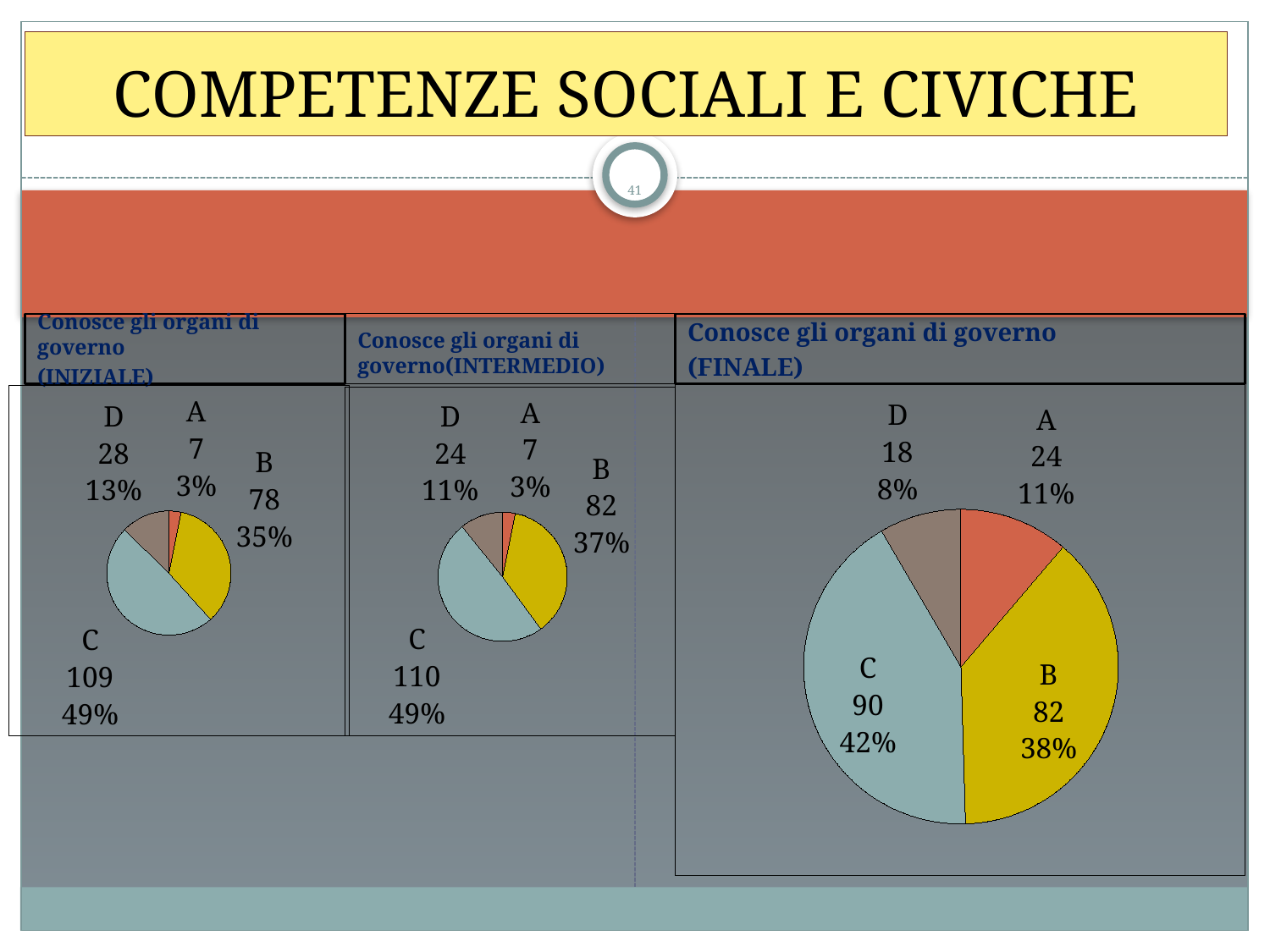
In the 'Conosce gli organi di governo(INTERMEDIO)' chart, what is the difference between the values for C and B? 28 What type of chart is used in the 'Conosce gli organi di governo (FINALE)' panel? Pie chart In the 'Conosce gli organi di governo (INIZIALE)' chart, what percentage share does category B have? 35% In the 'Conosce gli organi di governo (FINALE)' chart, how many categories are shown? 4 How many charts are shown on the slide? 3 In the 'Conosce gli organi di governo (FINALE)' chart, what is the value for category A? 24 In the 'Conosce gli organi di governo (INIZIALE)' chart, what is the value for category C? 109 In the 'Conosce gli organi di governo (FINALE)' chart, what percentage share does category C have? 42% In the 'Conosce gli organi di governo(INTERMEDIO)' chart, what is the value for category D? 24 In the 'Conosce gli organi di governo (INIZIALE)' chart, which category has the smallest slice? A In the 'Conosce gli organi di governo(INTERMEDIO)' chart, which category has the largest slice? C In the 'Conosce gli organi di governo (FINALE)' chart, which is larger, the value for B or the value for D? B